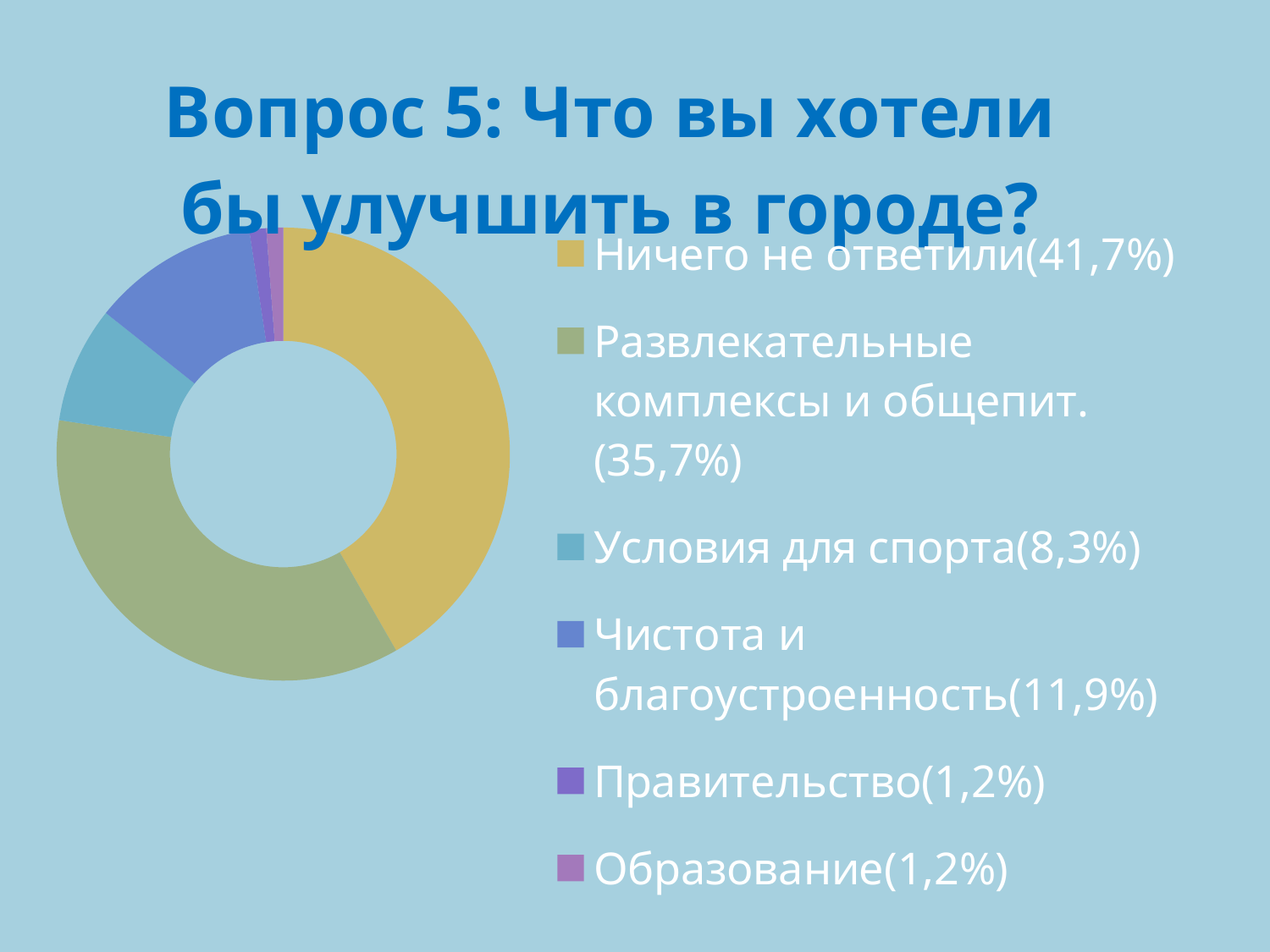
What percentage is shown for "Условия для спорта"? 8,3% What is the title of the slide? Вопрос 5: Что вы хотели бы улучшить в городе? Which colour represents "Ничего не ответили" in the chart? Yellow (gold) Which category has the larger share: "Условия для спорта" or "Чистота и благоустроенность"? Чистота и благоустроенность What share of the chart does "Ничего не ответили" represent? 41,7% What percentage is shown for "Развлекательные комплексы и общепит."? 35,7% What is the difference in percentage points between "Чистота и благоустроенность" and "Условия для спорта"? 3,6 percentage points How many categories does the legend list? 6 What kind of chart is shown on the slide? Doughnut (pie) chart What percentage is shown for "Чистота и благоустроенность"? 11,9% What is the difference in percentage points between "Ничего не ответили" and "Развлекательные комплексы и общепит."? 6 percentage points Which category has the largest share of the chart? Ничего не ответили